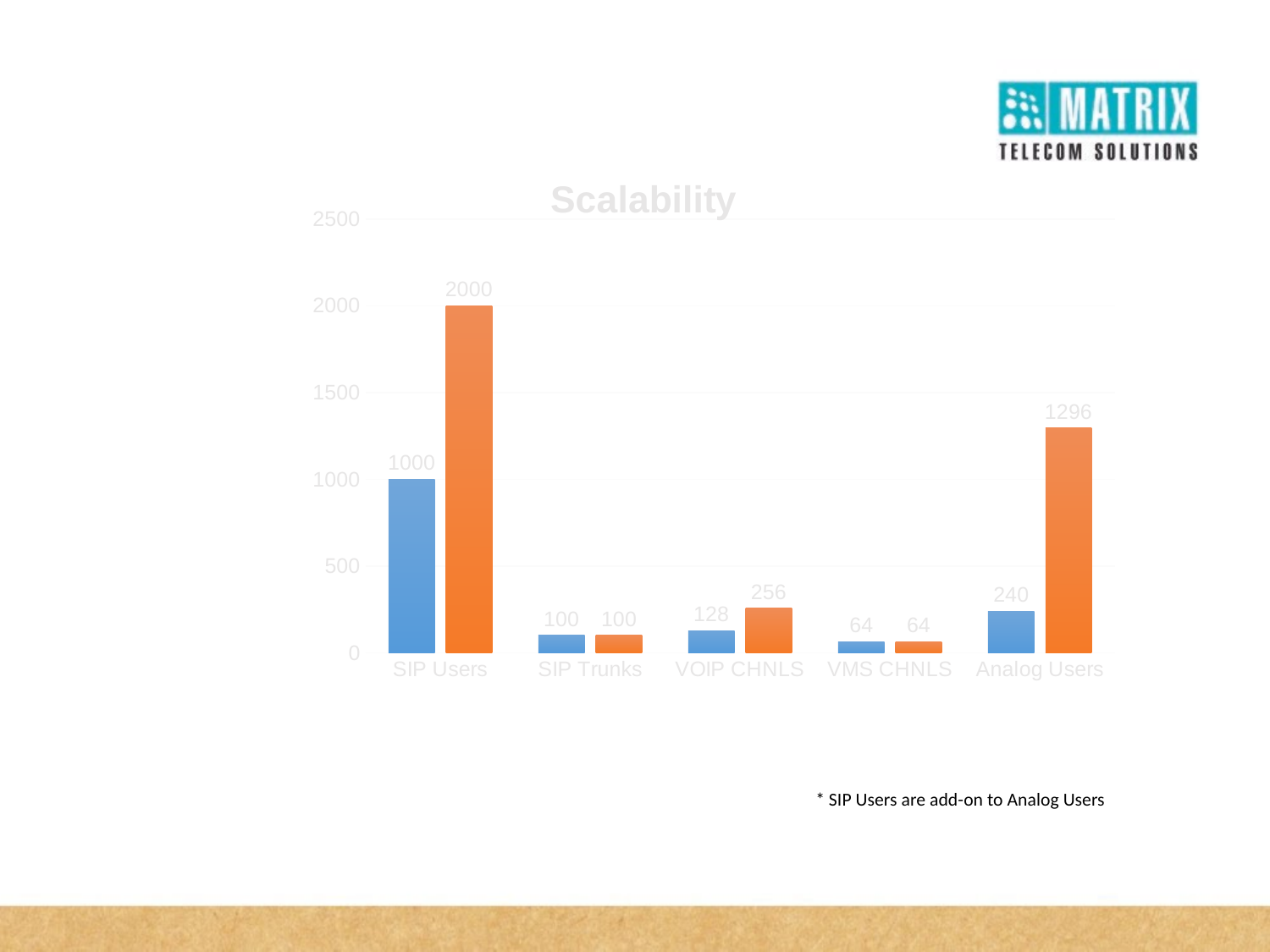
What is the value of the blue bar for SIP Users? 1000 What is the title of the chart? Scalability What is the value of the orange bar for SIP Users? 2000 Which category has the highest orange bar? SIP Users What is the difference between the orange bar for SIP Users and the orange bar for Analog Users? 704 Which is larger, the orange bar for VOIP CHNLS or the blue bar for Analog Users? the orange bar for VOIP CHNLS Which category has the lowest blue bar? VMS CHNLS What is the value of the blue bar for VOIP CHNLS? 128 What is the value of the orange bar for Analog Users? 1296 How many categories are shown on the x axis of the chart? 5 What is the difference between the orange and blue bars for Analog Users? 1056 What type of chart is shown on the slide? bar chart